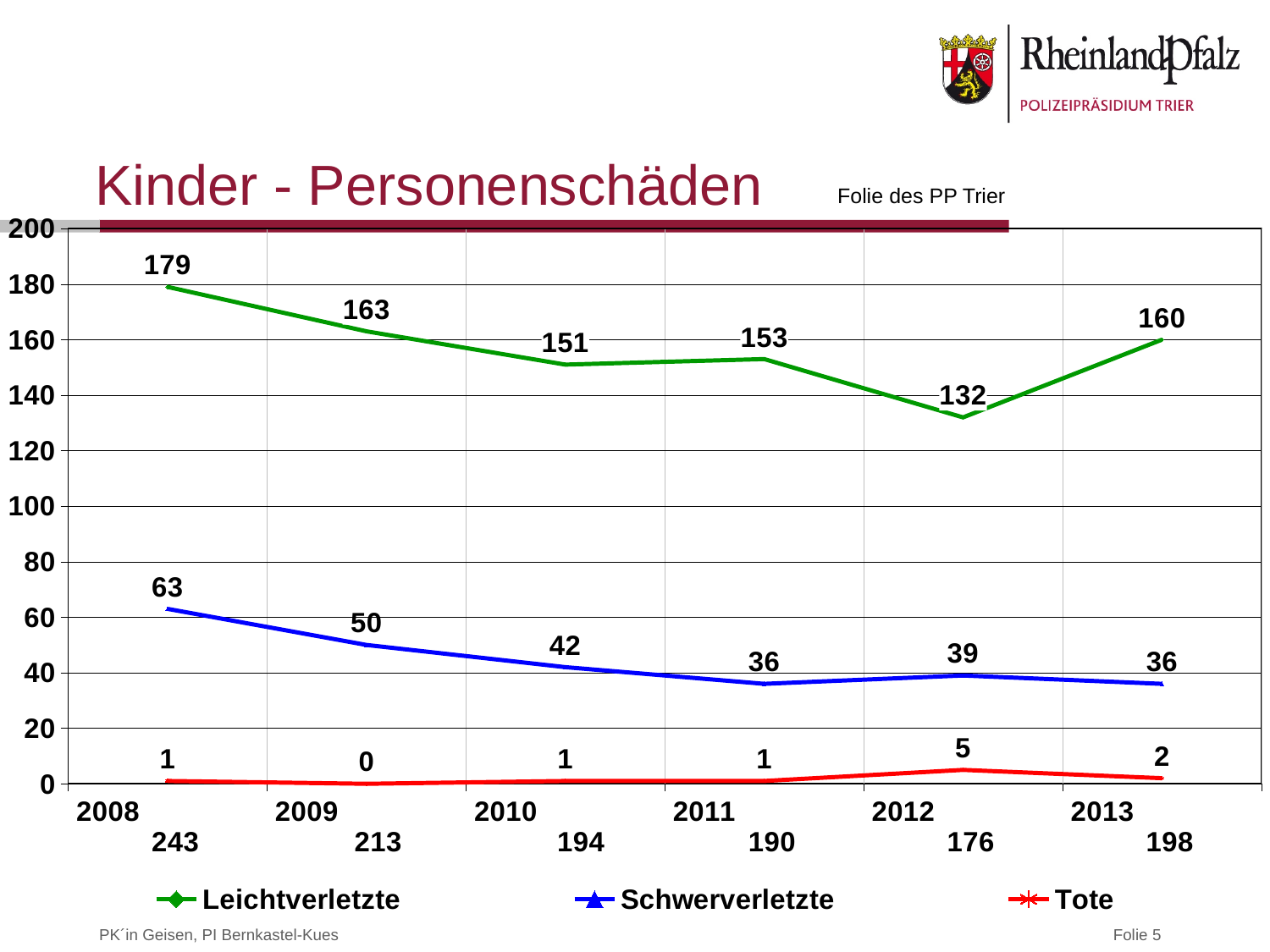
How many series does the legend list? 3 What is the value for Schwerverletzte in 2010? 42 What is the value for Leichtverletzte in 2008? 179 What is the difference between the Leichtverletzte values in 2008 and 2013? 19 Is the Leichtverletzte value for 2012 greater or less than 140? less Does the Schwerverletzte series rise or fall from 2008 to 2010? fall What kind of chart is shown on the slide? line chart Which is larger, the Schwerverletzte value in 2011 or in 2012? 2012 What is the value for Tote in 2012? 5 How many years are shown on the x axis? 6 In which year is the Leichtverletzte value lowest? 2012 In which year is the Schwerverletzte value highest? 2008